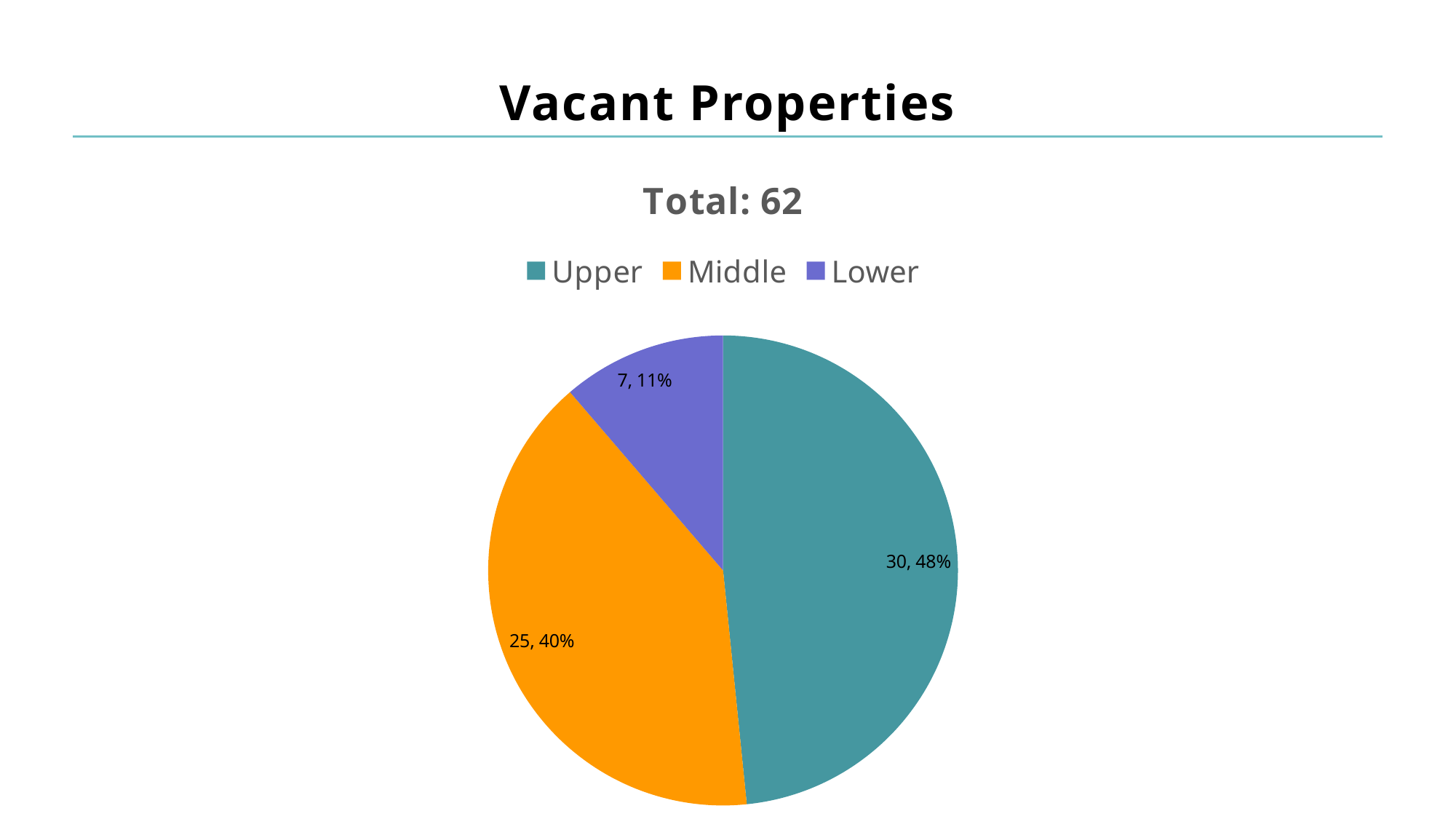
Which category has the smallest number of vacant properties? Lower How many vacant properties are in the Upper category? 30 Which category has the largest number of vacant properties? Upper What is the total number of vacant properties shown on the slide? 62 What percentage share of the pie does the Upper slice represent? 48% What type of chart is shown on the slide? Pie chart How many categories does the pie chart show? 3 Which has more vacant properties, Middle or Lower? Middle How many vacant properties are in the Lower category? 7 What percentage share of the pie does the Lower slice represent? 11% How many vacant properties are in the Middle category? 25 What is the difference between the Upper and Middle vacant property counts? 5